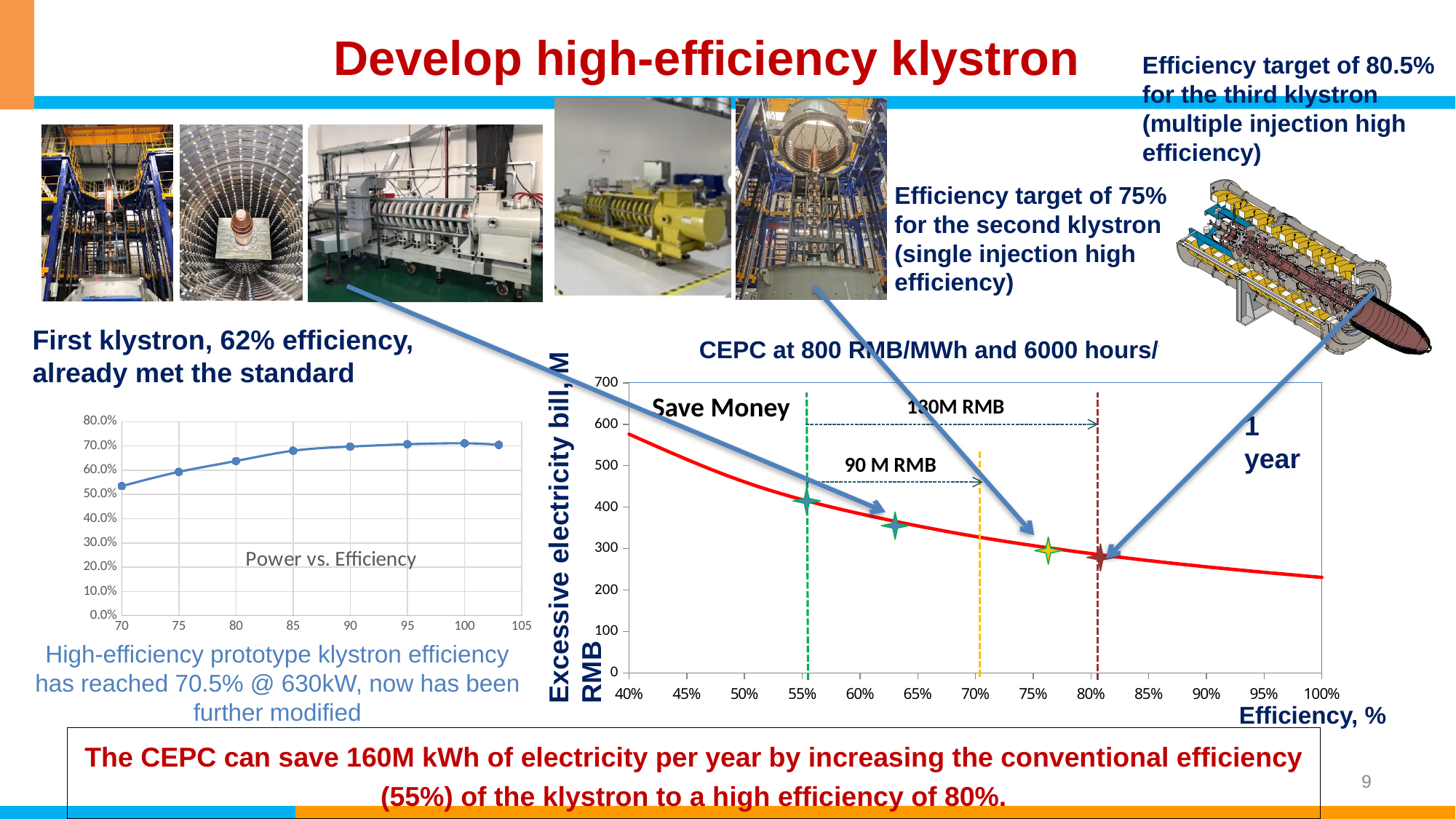
In the 'CEPC at 800 RMB/MWh and 6000 hours/1 year' chart on the right, is the value of the red curve at 40% efficiency greater or less than 500? greater In the 'Power vs. Efficiency' chart on the left, is the value at x = 85 greater or less than 60.0%? greater In the 'Power vs. Efficiency' chart on the left, which x value has the lowest plotted value? 70 In the 'Power vs. Efficiency' chart on the left, do the values rise or fall as the x axis increases from 70 to 100? rise In the 'Power vs. Efficiency' chart on the left, is the value at x = 80 greater or less than 70.0%? less What kind of chart is the 'CEPC at 800 RMB/MWh and 6000 hours/1 year' chart on the right? line chart What kind of chart is the 'Power vs. Efficiency' chart on the left? line chart What is the y-axis label of the 'CEPC at 800 RMB/MWh and 6000 hours/1 year' chart on the right? Excessive electricity bill, M RMB In the 'CEPC at 800 RMB/MWh and 6000 hours/1 year' chart on the right, does the red curve rise or fall as efficiency increases? fall How many data points are plotted in the 'Power vs. Efficiency' chart on the left? 8